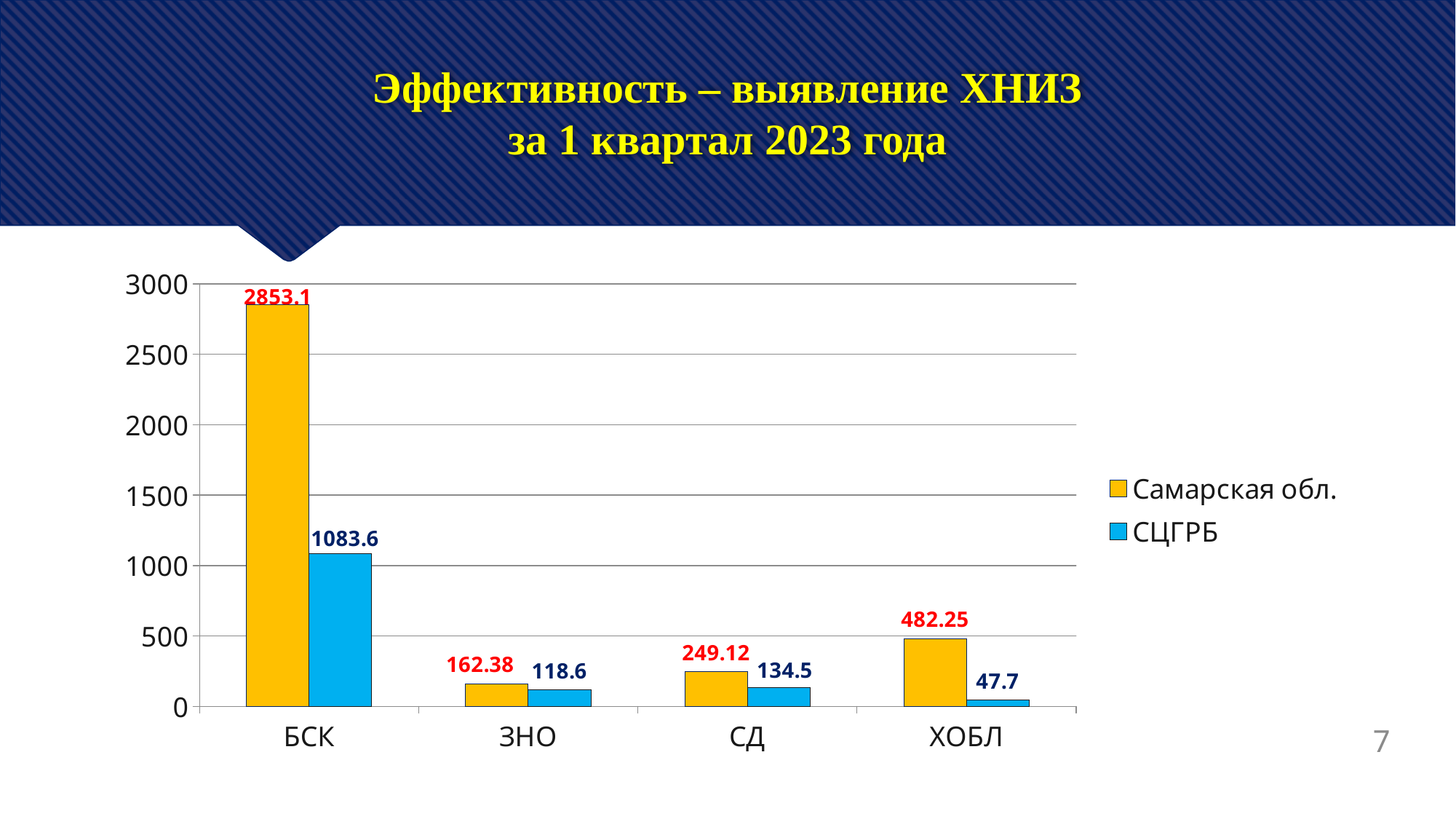
What is the difference between the Самарская обл. and СЦГРБ values in the БСК category? 1769.5 What is the value for Самарская обл. in the БСК category? 2853.1 What is the value for СЦГРБ in the ЗНО category? 118.6 Which is larger: the Самарская обл. value for ЗНО or the Самарская обл. value for СД? СД Which category has the lowest value for СЦГРБ? ХОБЛ How many series does the legend list? 2 What kind of chart is shown on the slide? Bar chart What is the value for Самарская обл. in the СД category? 249.12 Which category has the highest value for Самарская обл.? БСК How many categories are shown on the x axis? 4 What is the value for СЦГРБ in the ХОБЛ category? 47.7 What is the difference between the Самарская обл. and СЦГРБ values in the ХОБЛ category? 434.55